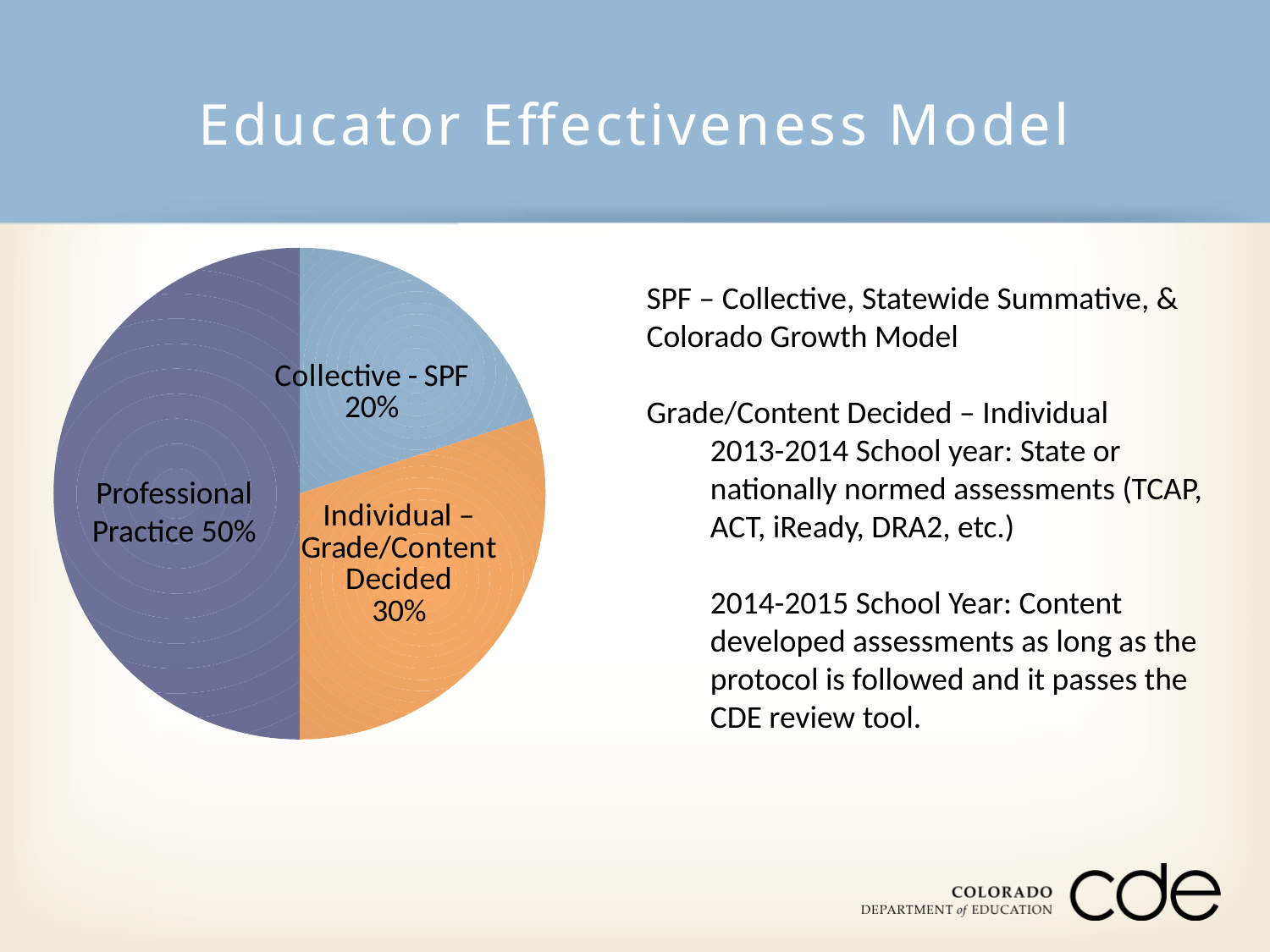
Which slice of the pie is the largest? Professional Practice What share of the pie does Professional Practice represent? 50% What is the difference in percentage points between Individual – Grade/Content Decided and Collective - SPF? 10 What share of the pie does Individual – Grade/Content Decided represent? 30% Which slice of the pie is the smallest? Collective - SPF What kind of chart is shown on the slide? pie chart Which is larger, the Individual – Grade/Content Decided slice or the Collective - SPF slice? Individual – Grade/Content Decided What share of the pie does Collective - SPF represent? 20% What is the combined share of Collective - SPF and Individual – Grade/Content Decided? 50% What is the difference in percentage points between Professional Practice and Collective - SPF? 30 What colour is the Professional Practice slice? purple How many slices does the pie chart have? 3